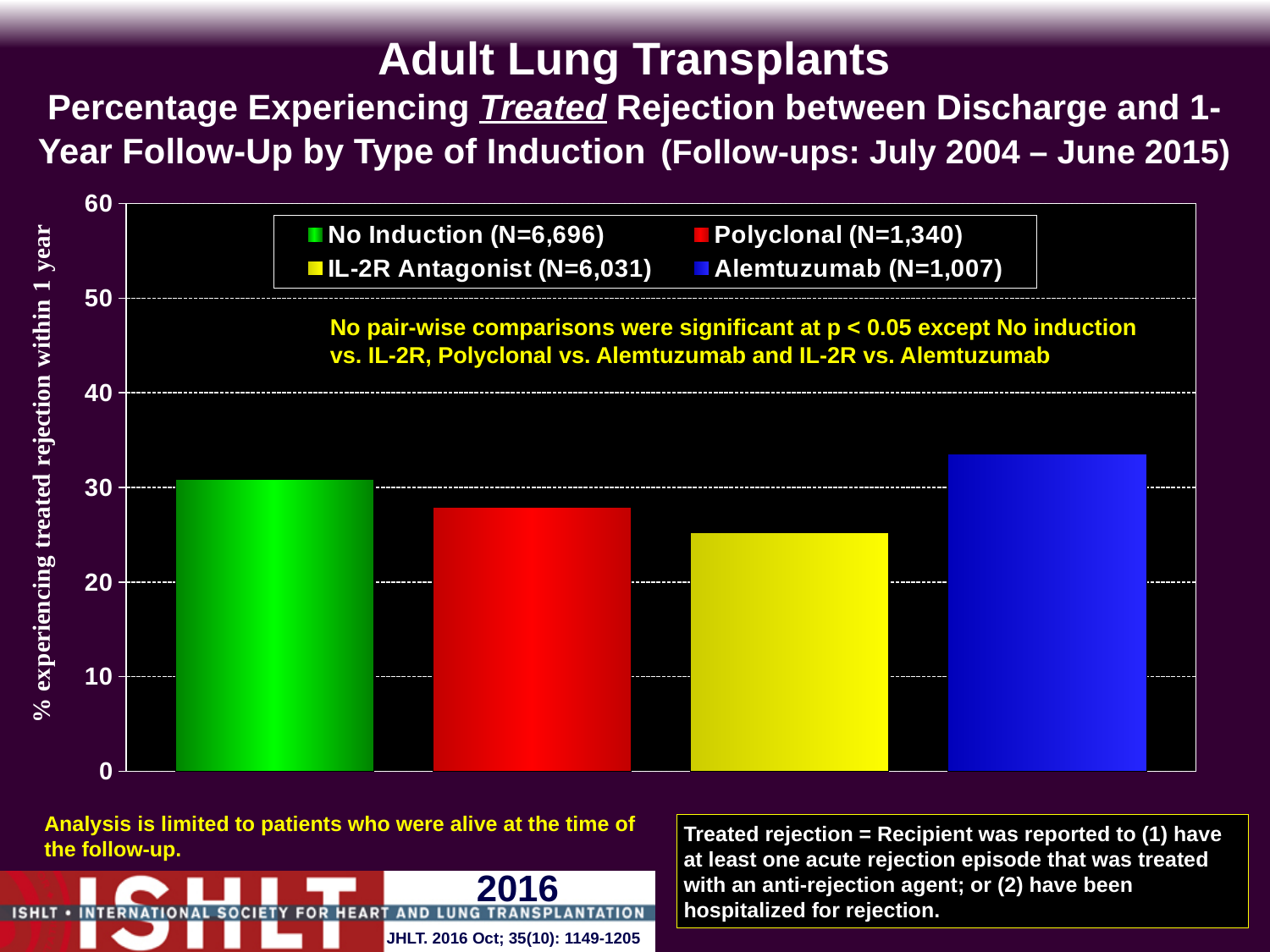
Is the value for Polyclonal greater or less than 30? less Which is larger, the value for No Induction or the value for Polyclonal? No Induction Which is larger, the value for Polyclonal or the value for IL-2R Antagonist? Polyclonal Is the value for IL-2R Antagonist greater or less than 20? greater What kind of chart is shown on the slide? bar chart Which induction type has the lowest percentage experiencing treated rejection within 1 year? IL-2R Antagonist How many series does the legend list? 4 Which induction type has the highest percentage experiencing treated rejection within 1 year? Alemtuzumab Is the value for Alemtuzumab greater or less than 40? less What colour is the bar for Alemtuzumab? blue How many induction types (bars) are plotted in the chart? 4